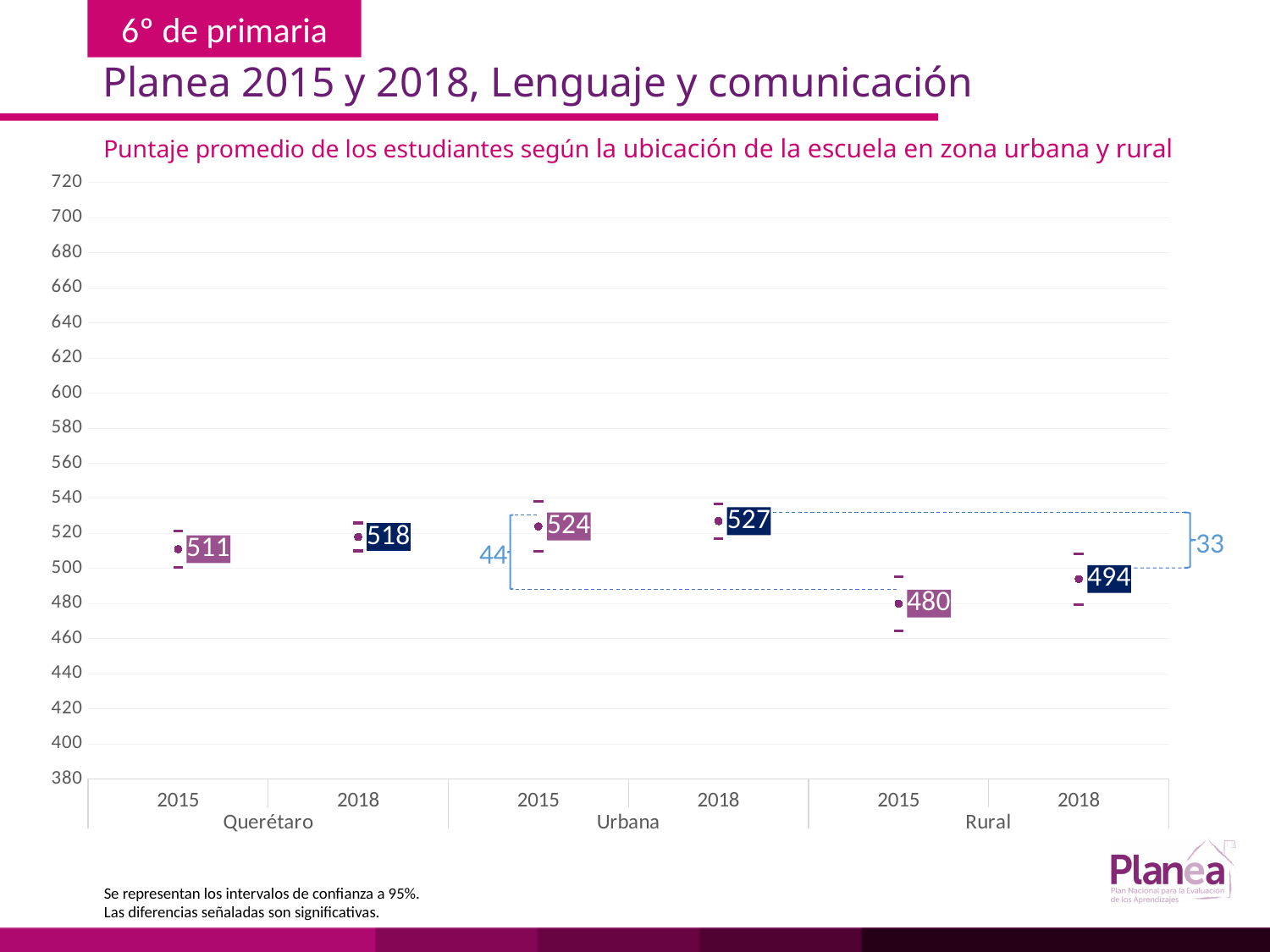
By how many points did the Rural average score change from 2015 to 2018? 14 What is the difference between the Urbana and Rural average scores in 2015? 44 Which is larger, the Querétaro 2018 score or the Rural 2018 score? Querétaro 2018 What is the difference between the Urbana and Rural average scores in 2018? 33 What is the average score for Querétaro in 2015? 511 Do the average scores rise or fall from 2015 to 2018 for each group? rise Which group and year has the highest average score? Urbana 2018 What is the average score for Urbana schools in 2018? 527 What is the average score for Rural schools in 2015? 480 Which group and year has the lowest average score? Rural 2015 What is the average score for Querétaro in 2018? 518